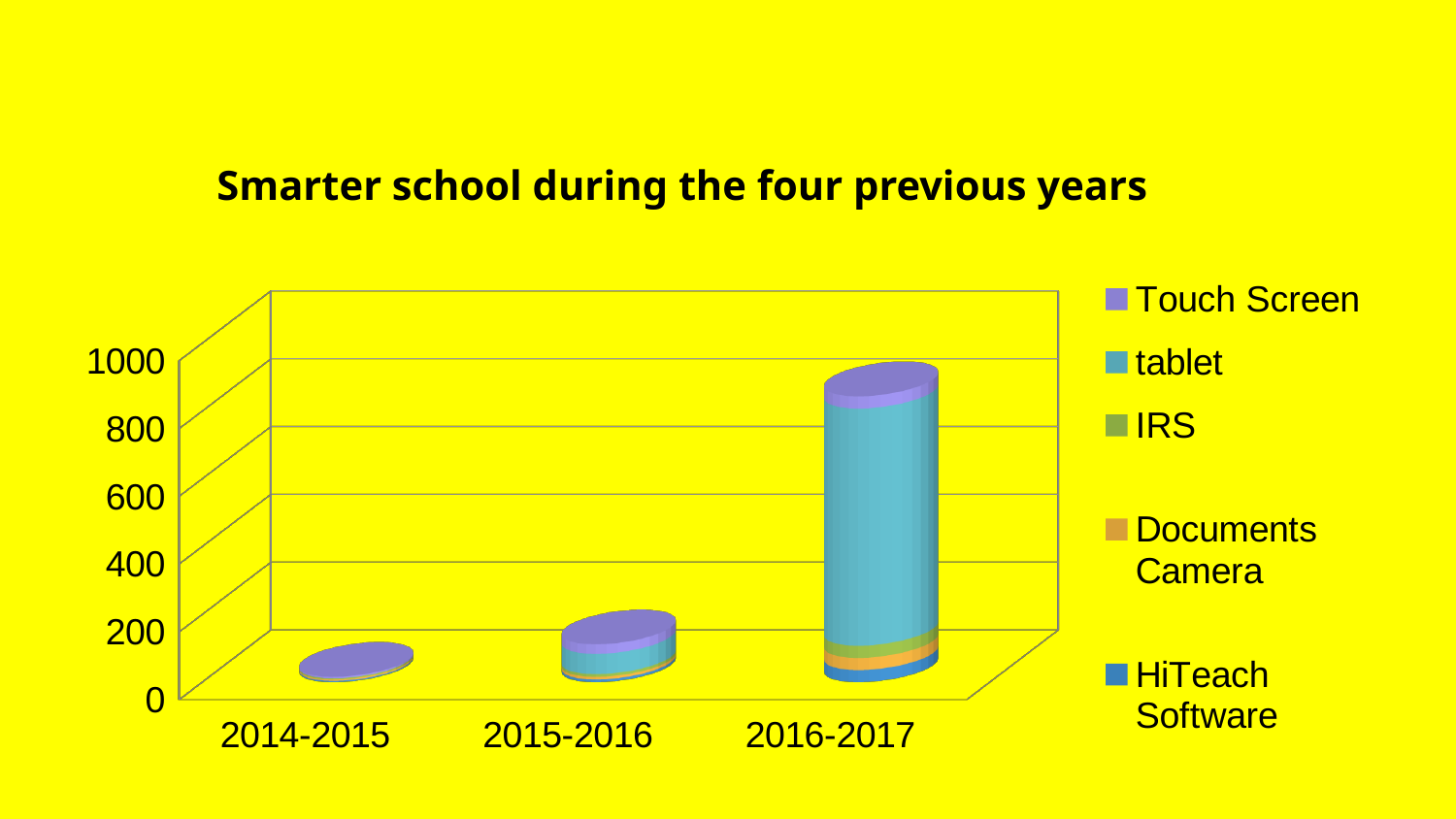
Is the total for 2014-2015 greater or less than 200? less How many series does the chart's legend list? 5 What is the title of the chart? Smarter school during the four previous years Which category has the tallest stacked bar? 2016-2017 Is the total for 2016-2017 greater or less than 800? greater Is the total for 2015-2016 greater or less than 400? less Which category has the shortest stacked bar? 2014-2015 Do the stacked bar totals rise or fall from 2014-2015 to 2016-2017? rise Which is larger, the stacked bar for 2015-2016 or the stacked bar for 2016-2017? 2016-2017 How many categories are shown on the x axis of the chart? 3 What kind of chart is shown on the slide? bar chart Which series is listed last in the chart's legend? HiTeach Software